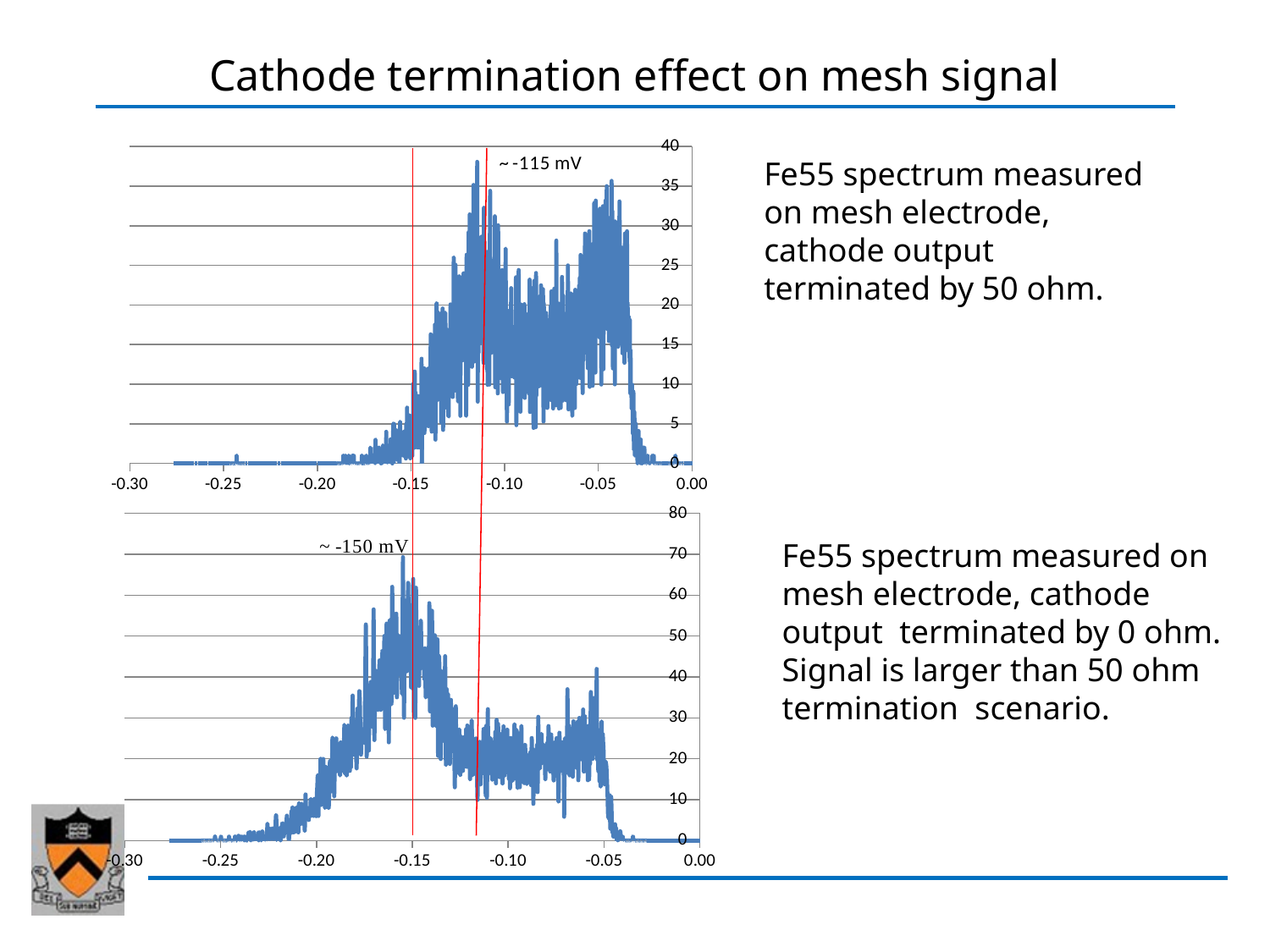
What kind of chart is the bottom chart on the slide? line chart In the top chart, what is the highest value shown on the vertical axis? 40 In the top chart, is the maximum height of the spectrum greater or less than 35? greater In the bottom chart, what is the highest value shown on the vertical axis? 80 How many charts are shown on the slide? 2 In the bottom chart, what peak position is written in the annotation? ~ -150 mV In the bottom chart, is the maximum height of the spectrum greater or less than 60? greater What kind of chart is the top chart on the slide? line chart Which chart reaches a higher peak count, the top chart or the bottom chart? the bottom chart In the bottom chart, is the value at -0.25 on the horizontal axis greater or less than 10? less In the top chart, what peak position is written in the annotation next to the red line? ~ -115 mV